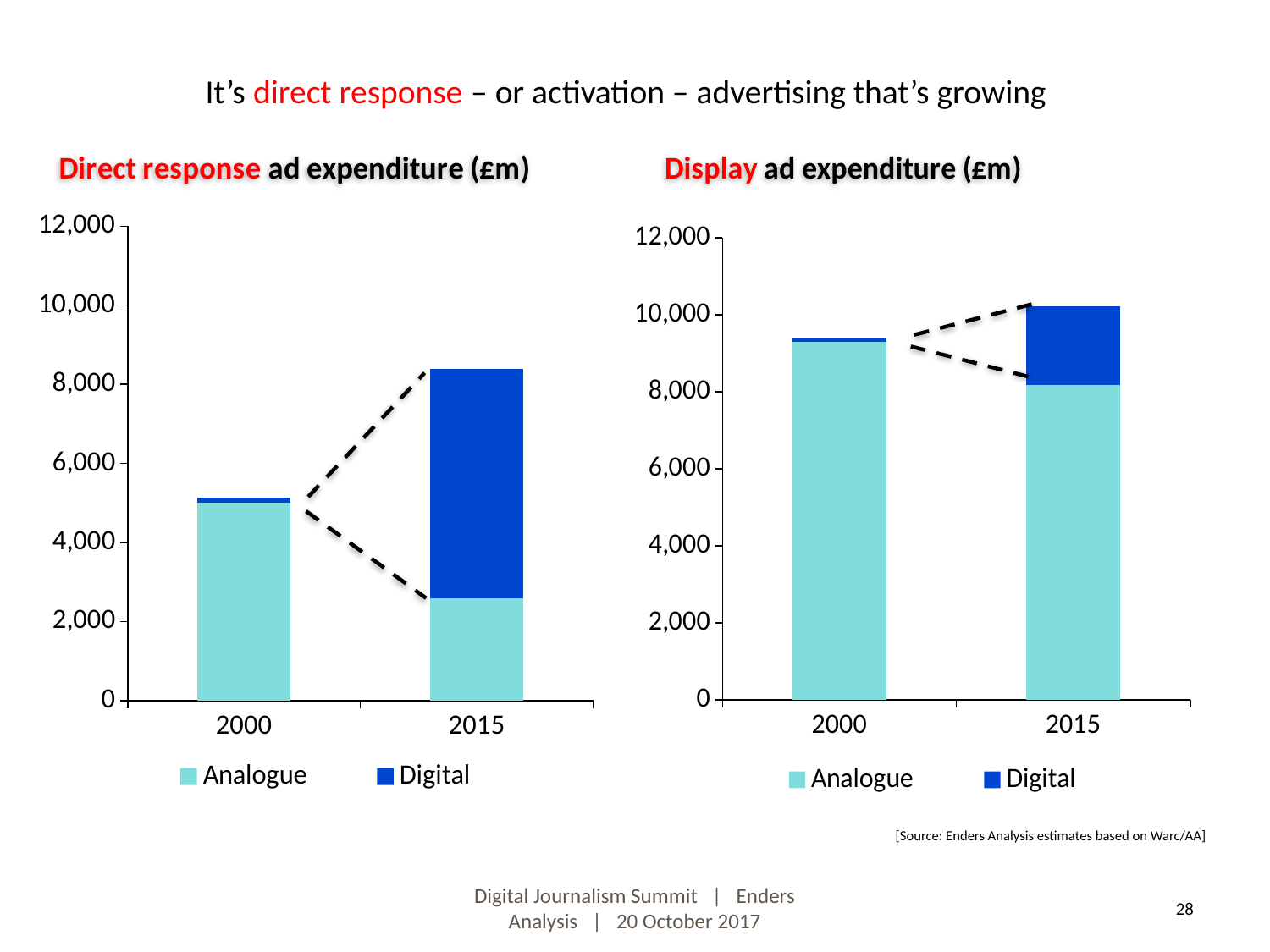
In the Direct response ad expenditure (£m) chart, is the Analogue value for 2015 greater or less than 4,000? less In the Display ad expenditure (£m) chart, is the Analogue value for 2000 greater or less than 8,000? greater In the Display ad expenditure (£m) chart, is the total for 2000 greater or less than 10,000? less In the Direct response ad expenditure (£m) chart, does the total expenditure rise or fall from 2000 to 2015? rise How many years are shown on the x axis of the Display ad expenditure (£m) chart? 2 How many series does the legend of the Direct response ad expenditure (£m) chart list? 2 In the Direct response ad expenditure (£m) chart, which year has the larger total bar, 2000 or 2015? 2015 What are the two legend entries in the Display ad expenditure (£m) chart? Analogue and Digital What kind of chart is the Direct response ad expenditure (£m) chart? Stacked bar chart In the Display ad expenditure (£m) chart, which year has the larger Digital segment, 2000 or 2015? 2015